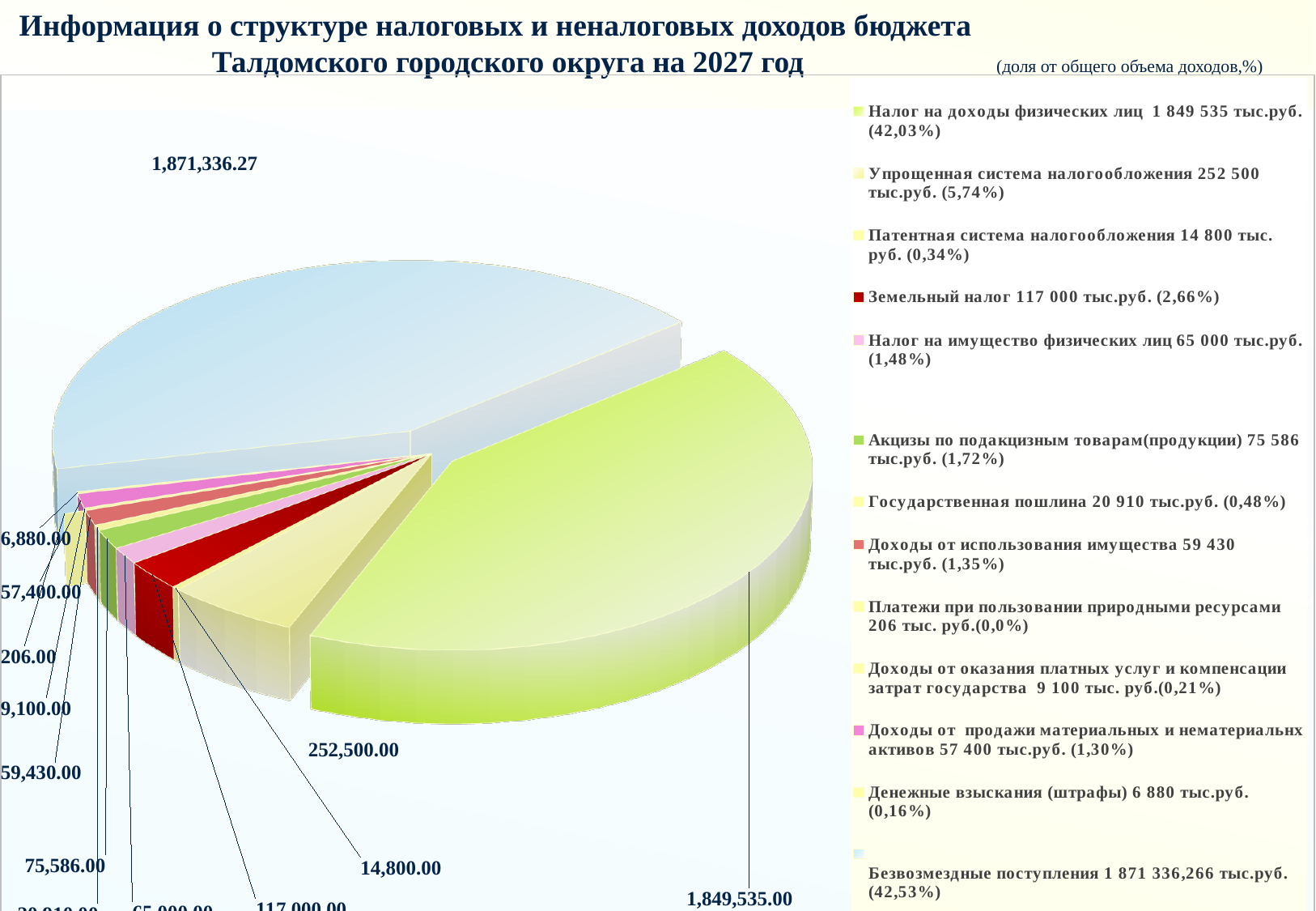
What kind of chart is shown on the slide? Pie chart Which category has the smallest share of the pie? Платежи при пользовании природными ресурсами What is the data label value for the slice 'Земельный налог'? 117,000.00 How many categories (slices) does the pie chart have? 13 Which category has the largest share of the pie? Безвозмездные поступления What is the data label value for the slice 'Упрощенная система налогообложения'? 252,500.00 What is the difference between the data label values for 'Упрощенная система налогообложения' and 'Земельный налог'? 135,500.00 According to the legend, what share of total revenue does 'Безвозмездные поступления' represent? 42,53% According to the legend, what share of total revenue does 'Акцизы по подакцизным товарам(продукции)' represent? 1,72% What is the data label value for the slice 'Налог на доходы физических лиц'? 1,849,535.00 Which is larger: the value for 'Налог на имущество физических лиц' or the value for 'Доходы от использования имущества'? Налог на имущество физических лиц What year does the chart title say the budget revenue structure refers to? 2027